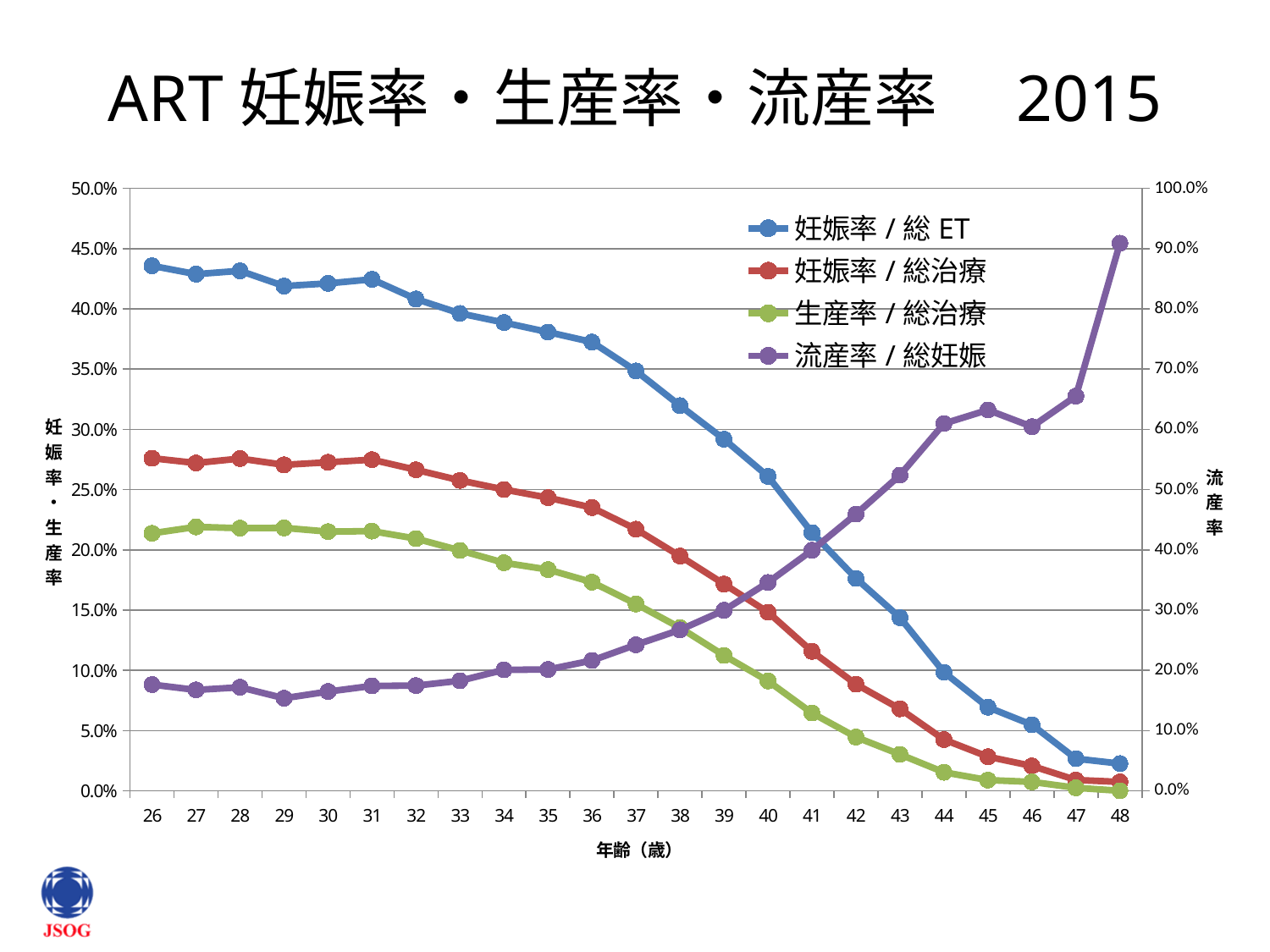
Is the 妊娠率 / 総 ET value at age 26 greater or less than 40.0%? greater What kind of chart is shown on the slide? line chart At which age is the 流産率 / 総妊娠 value highest? 48 Is the 流産率 / 総妊娠 value at age 48 greater or less than 80.0% on the right axis? greater How many series does the legend list? 4 What is the title of the chart? ART 妊娠率・生産率・流産率 2015 Does the 流産率 / 総妊娠 series rise or fall as age increases? rise At age 26, which is larger: 妊娠率 / 総 ET or 妊娠率 / 総治療? 妊娠率 / 総 ET What is the label of the x axis? 年齢（歳） How many age categories are plotted along the x axis? 23 At which age is the 妊娠率 / 総 ET value lowest? 48 Does the 妊娠率 / 総 ET series rise or fall as age increases? fall